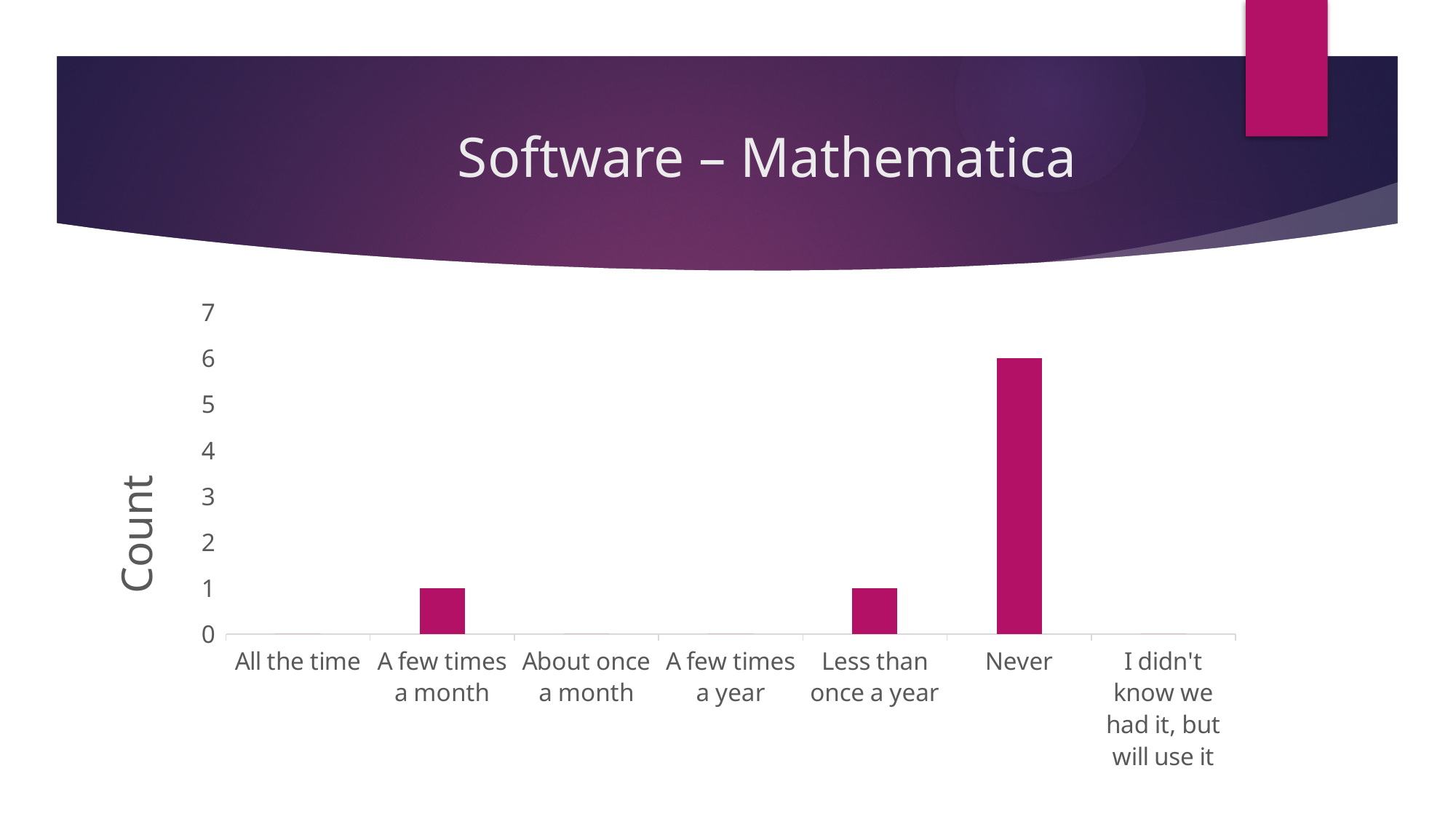
What is the count for "Less than once a year"? 1 What is the difference between the count for "Never" and the count for "Less than once a year"? 5 What is the title of the slide containing the chart? Software – Mathematica How many categories are shown on the x axis of the chart? 7 What type of chart is shown on the slide? bar chart Which is larger, the count for "Never" or the count for "A few times a month"? Never What is the count for "All the time"? 0 Which category has the highest count? Never What is the label on the vertical axis of the chart? Count What is the count for "A few times a month"? 1 Is the value for "Never" greater or less than 5? greater What is the count for "Never"? 6